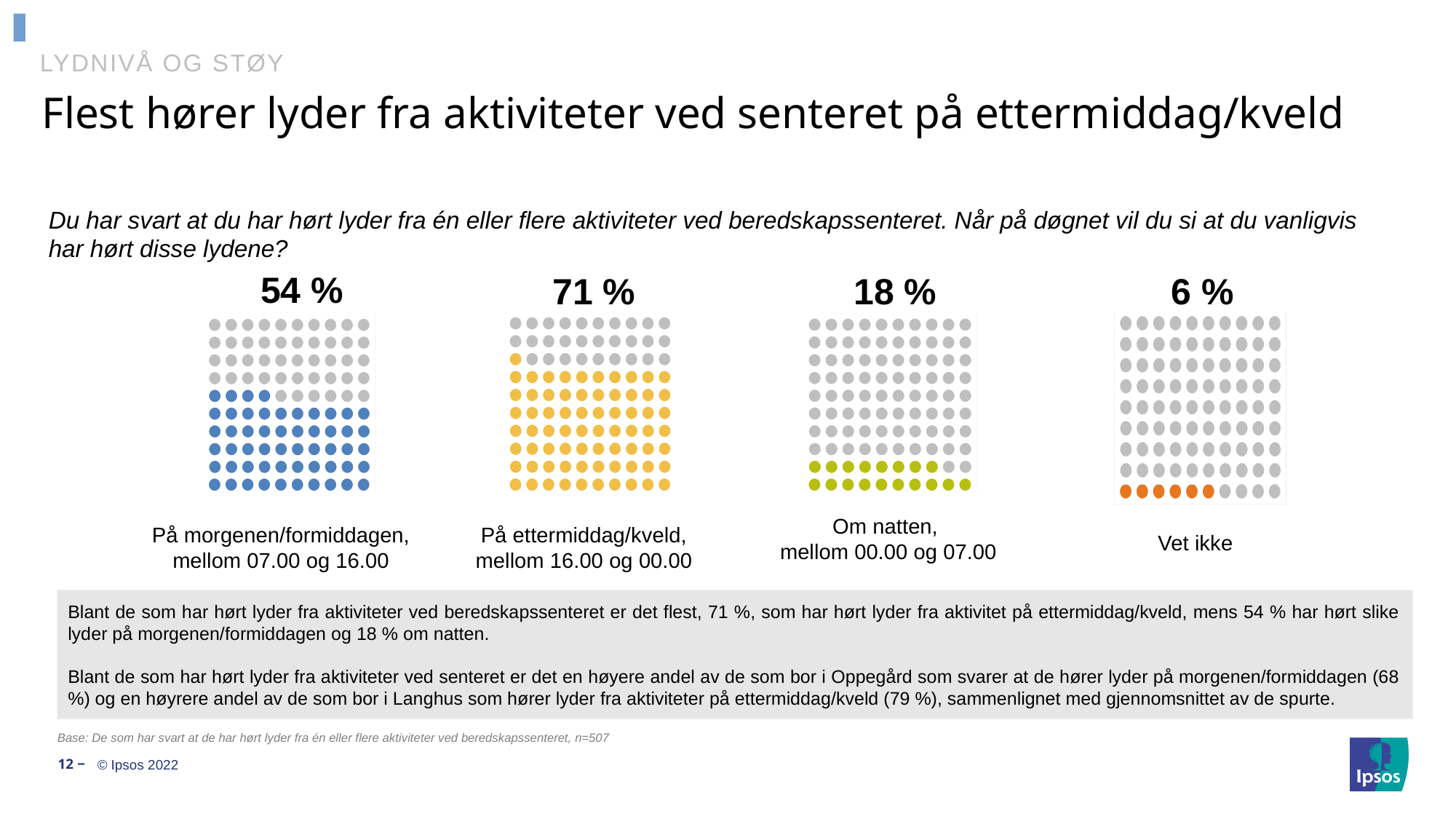
What percentage is shown for "På morgenen/formiddagen, mellom 07.00 og 16.00"? 54 % How many categories are shown on the slide? 4 What is the difference in percentage points between "Om natten" and "Vet ikke"? 12 What percentage is shown for "Om natten, mellom 00.00 og 07.00"? 18 % What percentage is shown for "På ettermiddag/kveld, mellom 16.00 og 00.00"? 71 % What is the difference in percentage points between "På ettermiddag/kveld" and "På morgenen/formiddagen"? 17 What colour are the filled dots for "Om natten, mellom 00.00 og 07.00"? Green Which is larger, the percentage for "På morgenen/formiddagen" or for "Om natten"? På morgenen/formiddagen What percentage is shown for "Vet ikke"? 6 % Which category has the lowest percentage? Vet ikke What kind of chart is used to display the percentages? Dot (waffle) chart Which category has the highest percentage? På ettermiddag/kveld, mellom 16.00 og 00.00